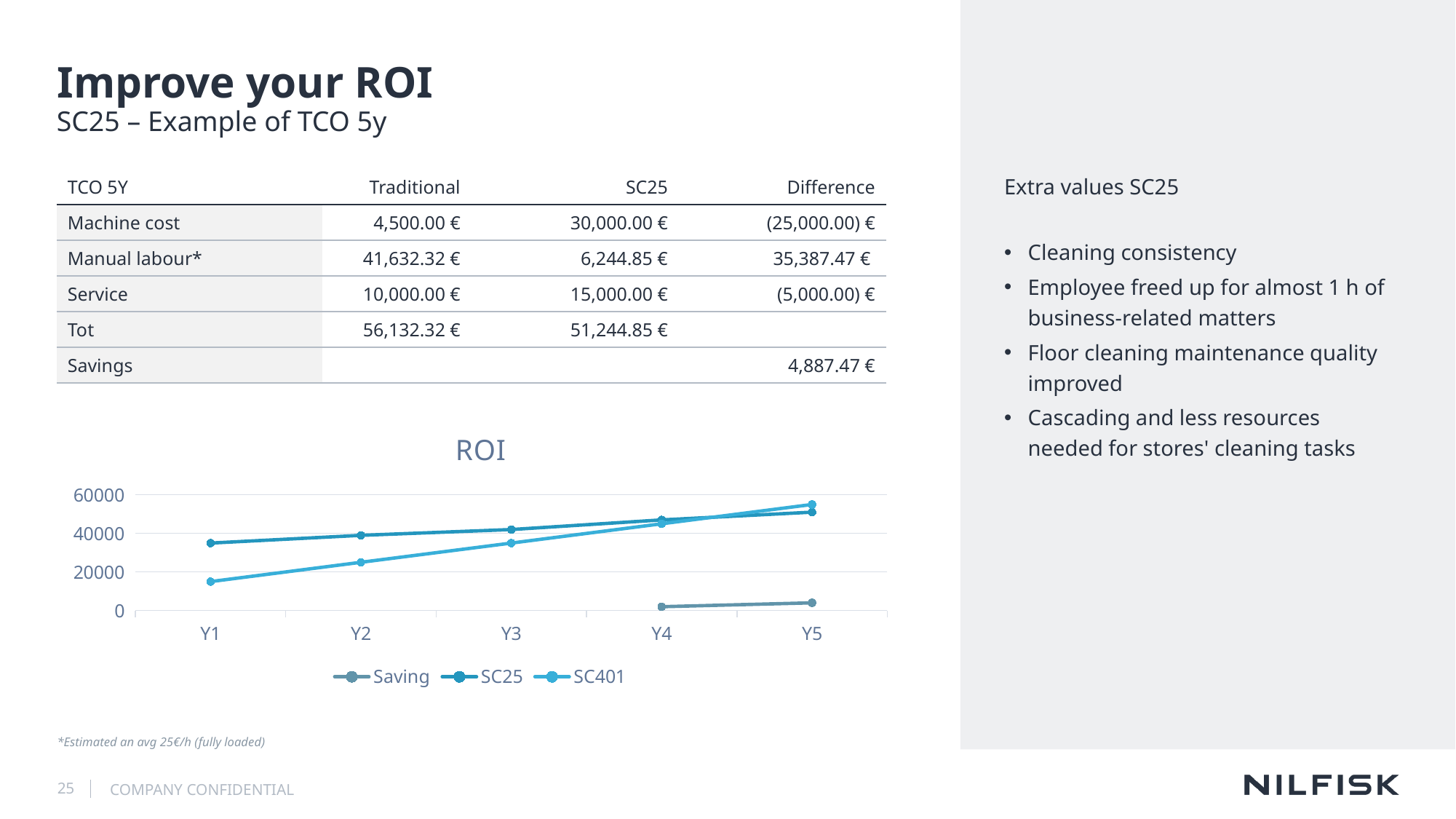
In the ROI chart, in which year is the SC401 value lowest? Y1 In the ROI chart, do the SC401 values rise or fall from Y1 to Y5? rise In the ROI chart, is the Saving value at Y5 greater or less than 20000? less In the ROI chart, do the SC25 values rise or fall from Y1 to Y5? rise In the ROI chart, is the SC401 value at Y1 greater or less than 20000? less In the ROI chart, which series has the larger value at Y1, SC25 or SC401? SC25 In the ROI chart, is the SC401 value at Y5 greater or less than 40000? greater How many years are shown on the x axis of the ROI chart? 5 Which series are listed in the legend of the ROI chart? Saving, SC25, SC401 What kind of chart is the ROI chart? line chart How many series does the legend of the ROI chart list? 3 What is the title of the line chart? ROI